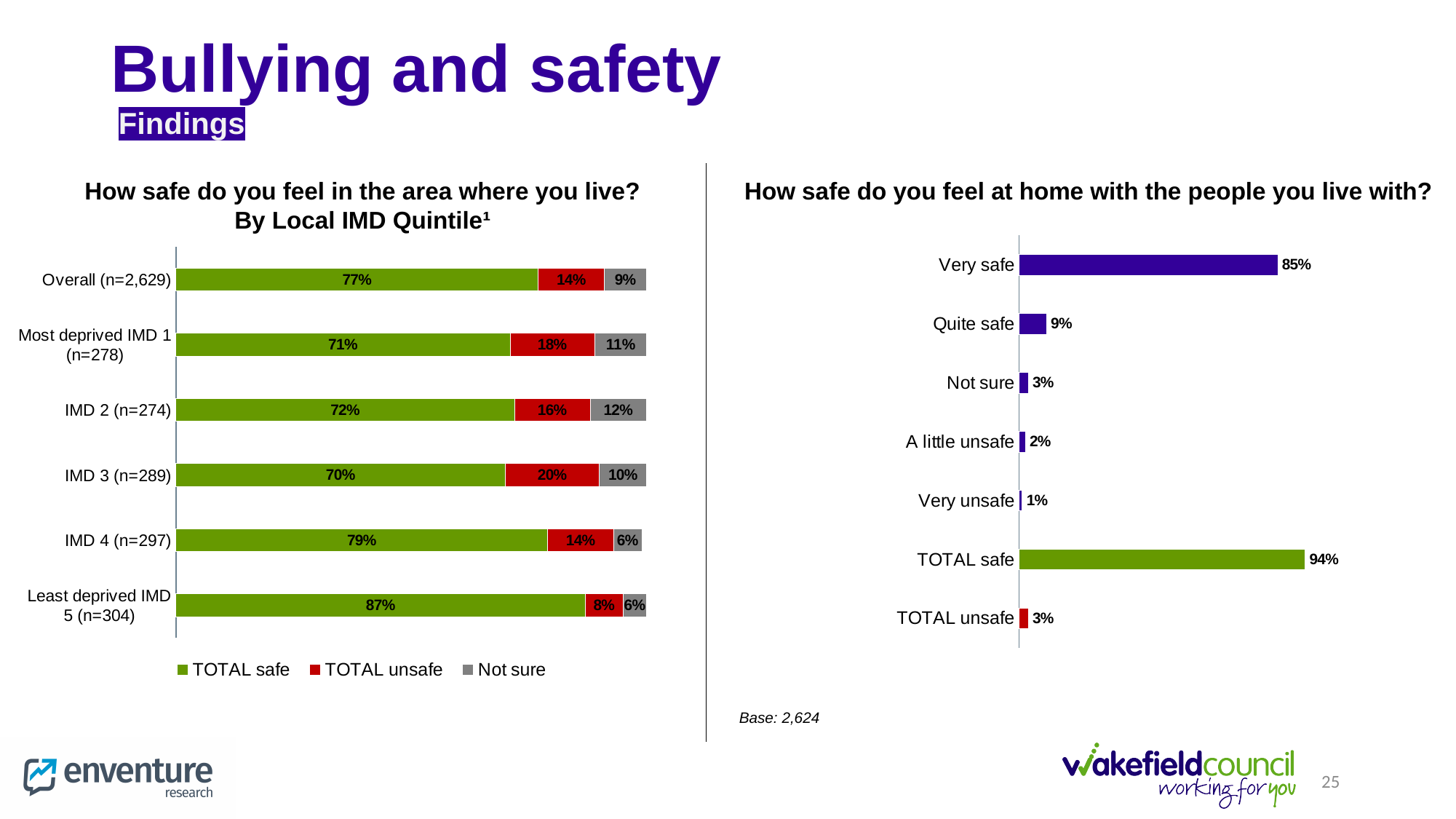
In the chart 'How safe do you feel in the area where you live? By Local IMD Quintile', which category has the lowest Not sure value? IMD 4 (n=297) and Least deprived IMD 5 (n=304) In the chart 'How safe do you feel in the area where you live? By Local IMD Quintile', how many categories are shown? 6 In the chart 'How safe do you feel in the area where you live? By Local IMD Quintile', what is the TOTAL unsafe value for Most deprived IMD 1 (n=278)? 18% In the chart 'How safe do you feel in the area where you live? By Local IMD Quintile', which category has the highest TOTAL safe value? Least deprived IMD 5 (n=304) In the chart 'How safe do you feel at home with the people you live with?', what is the value for Quite safe? 9% In the chart 'How safe do you feel in the area where you live? By Local IMD Quintile', what is the TOTAL safe value for IMD 3 (n=289)? 70% In the chart 'How safe do you feel at home with the people you live with?', is the value for Very safe larger than the value for TOTAL safe? No, TOTAL safe is larger In the chart 'How safe do you feel in the area where you live? By Local IMD Quintile', how many series does the legend list? 3 In the chart 'How safe do you feel at home with the people you live with?', which category has the lowest value? Very unsafe In the chart 'How safe do you feel in the area where you live? By Local IMD Quintile', what is the difference between the TOTAL safe values for Least deprived IMD 5 (n=304) and Most deprived IMD 1 (n=278)? 16% In the chart 'How safe do you feel in the area where you live? By Local IMD Quintile', what is the total of the stacked bar for IMD 2 (n=274)? 100% What kind of chart is 'How safe do you feel at home with the people you live with?'? Bar chart